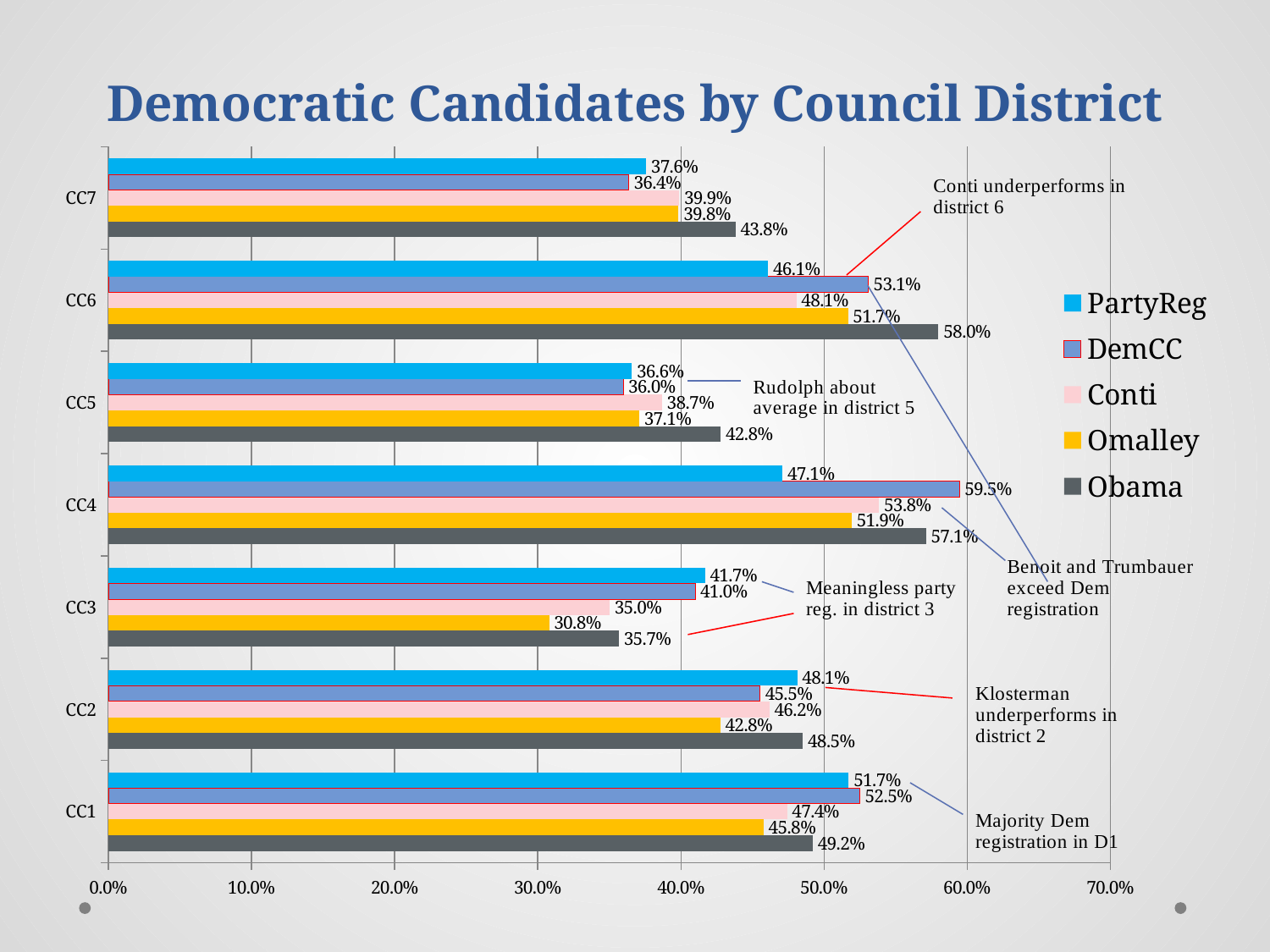
Which council district has the highest Obama value? CC6 What is the difference between the DemCC and PartyReg values for CC6? 7.0% What is the Obama value for CC6? 58.0% Which is larger for CC2, the PartyReg value or the DemCC value? PartyReg How many series does the legend list? 5 Which series is shown in yellow in the legend? Omalley Which council district has the lowest Omalley value? CC3 What kind of chart is shown on the slide? Bar chart What is the Conti value for CC1? 47.4% What is the DemCC value for CC4? 59.5% What is the Omalley value for CC3? 30.8% How many council districts are shown on the chart? 7